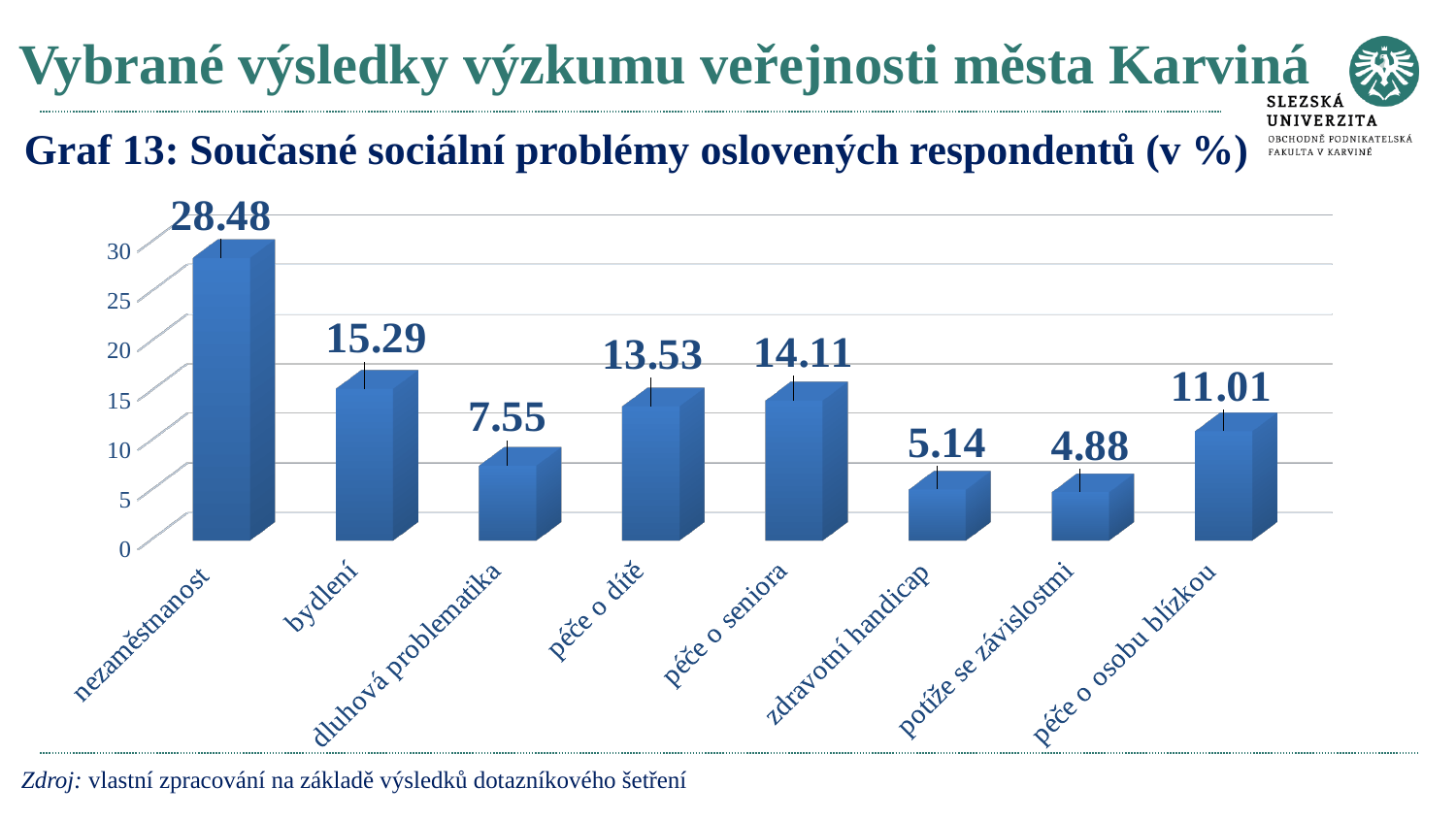
What is the difference between the values for nezaměstnanost and bydlení? 13.19 What is the value for péče o seniora? 14.11 Which category has the highest value? nezaměstnanost What is the value for péče o osobu blízkou? 11.01 What kind of chart is shown on the slide? bar chart Which category has the lowest value? potíže se závislostmi What is the difference between the values for péče o seniora and péče o dítě? 0.58 Which is larger, the value for bydlení or the value for péče o osobu blízkou? bydlení What is the value for dluhová problematika? 7.55 What is the value for nezaměstnanost? 28.48 How many categories are shown in the chart? 8 What is the title of the chart? Graf 13: Současné sociální problémy oslovených respondentů (v %)